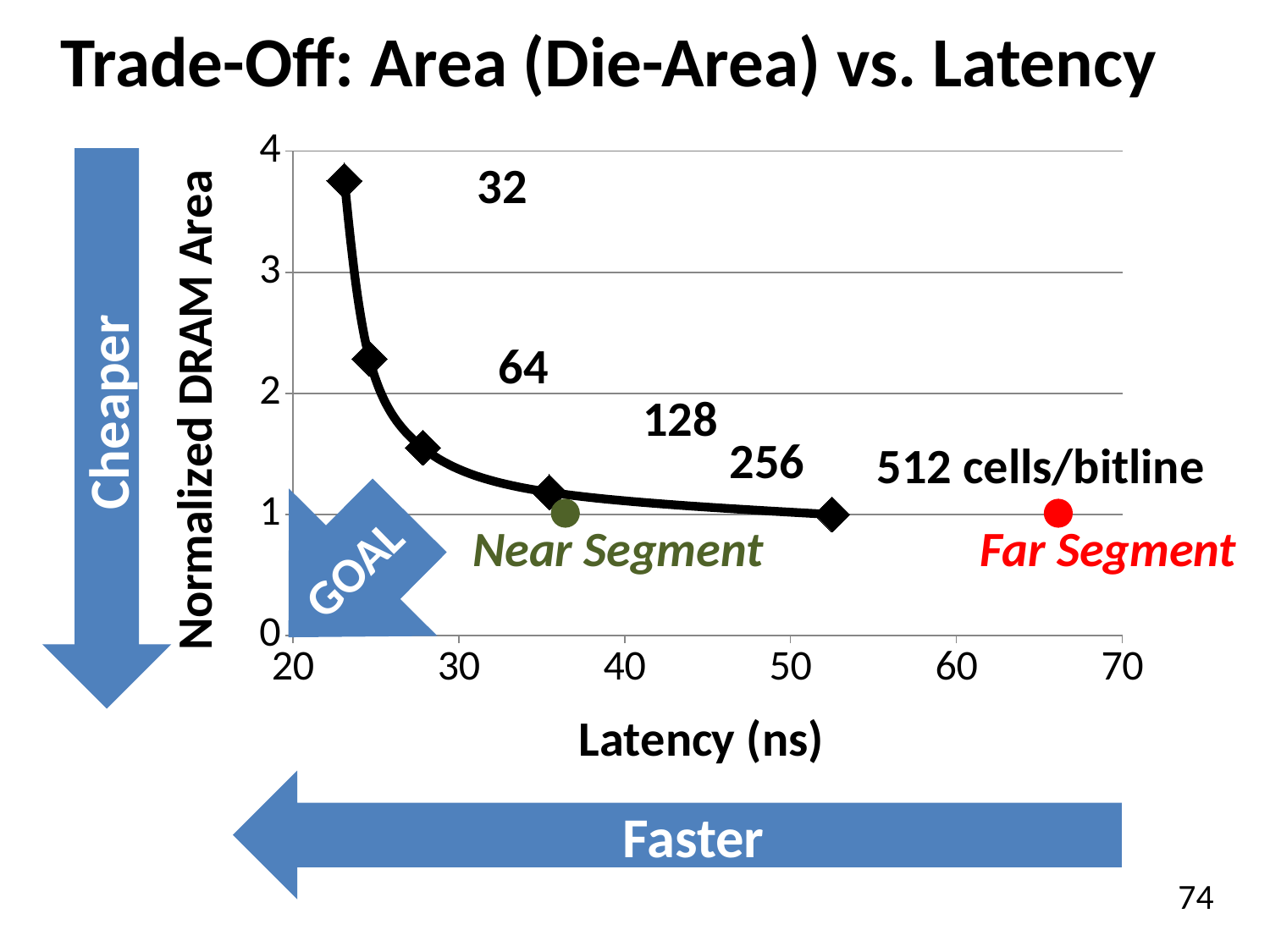
Which has a larger normalized DRAM area, 64 cells/bitline or 256 cells/bitline? 64 cells/bitline What is the label of the x axis? Latency (ns) Is the normalized DRAM area for 128 cells/bitline greater or less than 2? less How many black diamond data points are plotted on the curve? 5 As latency increases along the x axis, does the normalized DRAM area rise or fall? fall What is the title of the chart on the slide? Trade-Off: Area (Die-Area) vs. Latency Which cells/bitline configuration has the lowest normalized DRAM area? 512 cells/bitline Is the normalized DRAM area for 32 cells/bitline greater or less than 3? greater Is the latency of the Far Segment point greater or less than 60 ns? greater Which cells/bitline configuration has the highest normalized DRAM area? 32